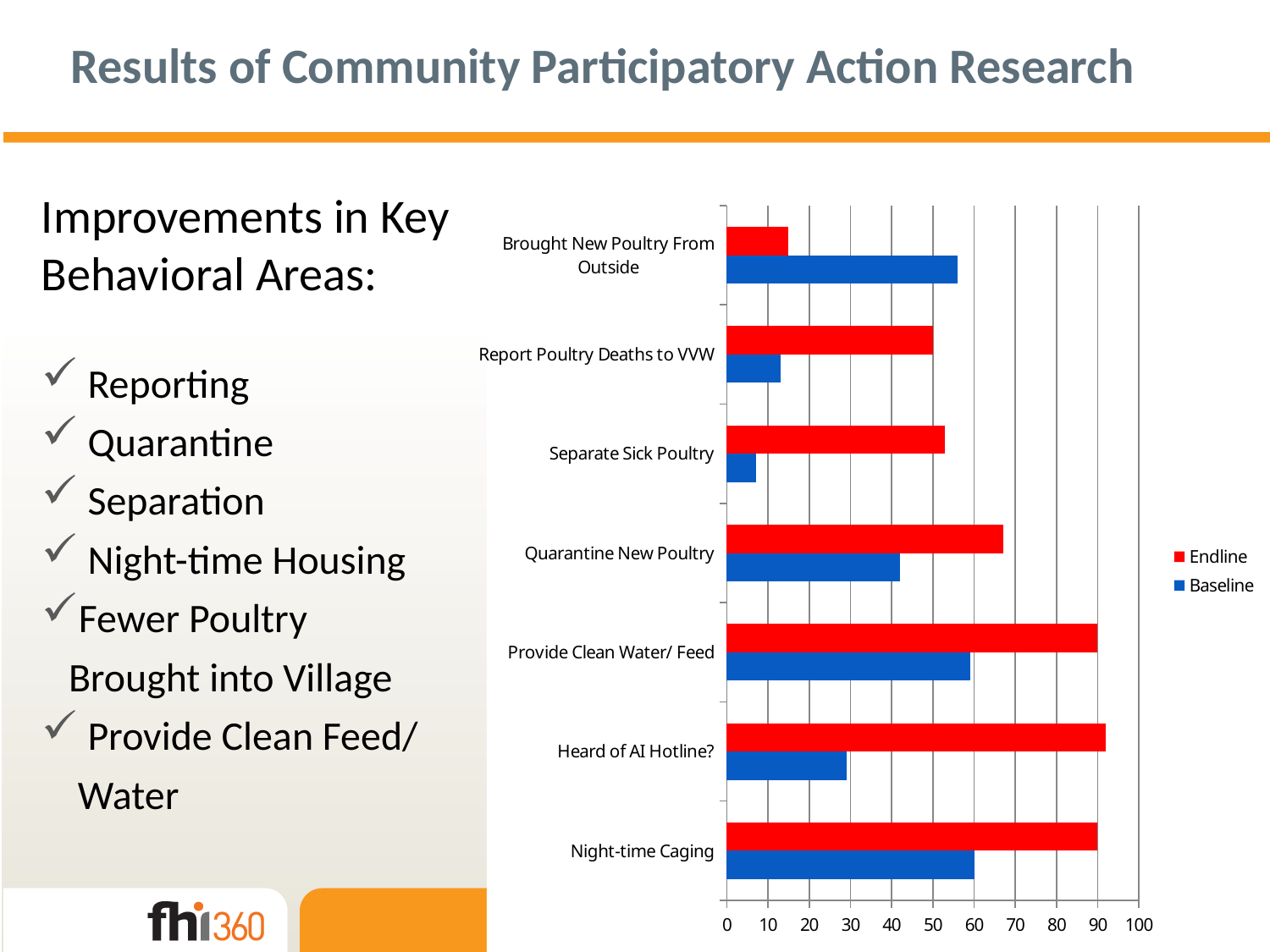
Which category has the lowest Endline value? Brought New Poultry From Outside For Separate Sick Poultry, which is larger, the Endline or the Baseline value? Endline Is the Endline value for Quarantine New Poultry greater or less than 60? greater How many series does the chart legend list? 2 Is the Baseline value for Heard of AI Hotline? greater or less than 40? less For Brought New Poultry From Outside, which is larger, the Endline or the Baseline value? Baseline Is the Baseline value for Separate Sick Poultry greater or less than 10? less Which category has the lowest Baseline value? Separate Sick Poultry Which colour represents the Endline series in the chart? red What kind of chart is shown on the slide? bar chart How many categories are plotted on the chart? 7